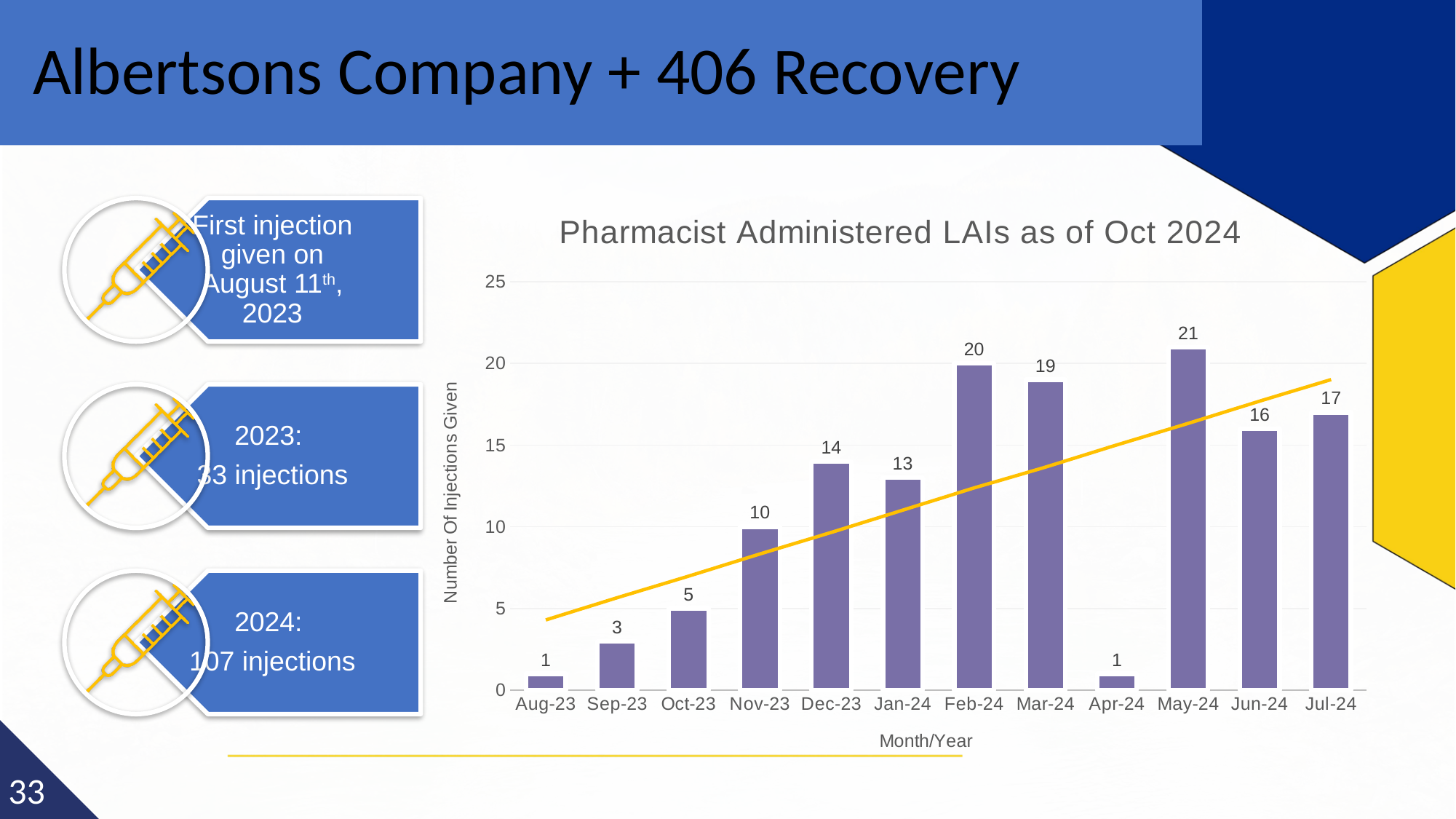
What type of chart is shown on the slide? bar chart How many injections were given in Nov-23? 10 Which month has the lowest number of injections given, other than Aug-23? Apr-24 How many injections were given in Feb-24? 20 Which month had more injections given, Dec-23 or Jan-24? Dec-23 What is the difference in injections given between May-24 and Jun-24? 5 Which month has the highest number of injections given? May-24 What is the title of the chart? Pharmacist Administered LAIs as of Oct 2024 How many months are shown on the x axis of the chart? 12 What is the difference in injections given between Feb-24 and Sep-23? 17 How many injections were given in Jul-24? 17 What is the label of the y axis? Number Of Injections Given